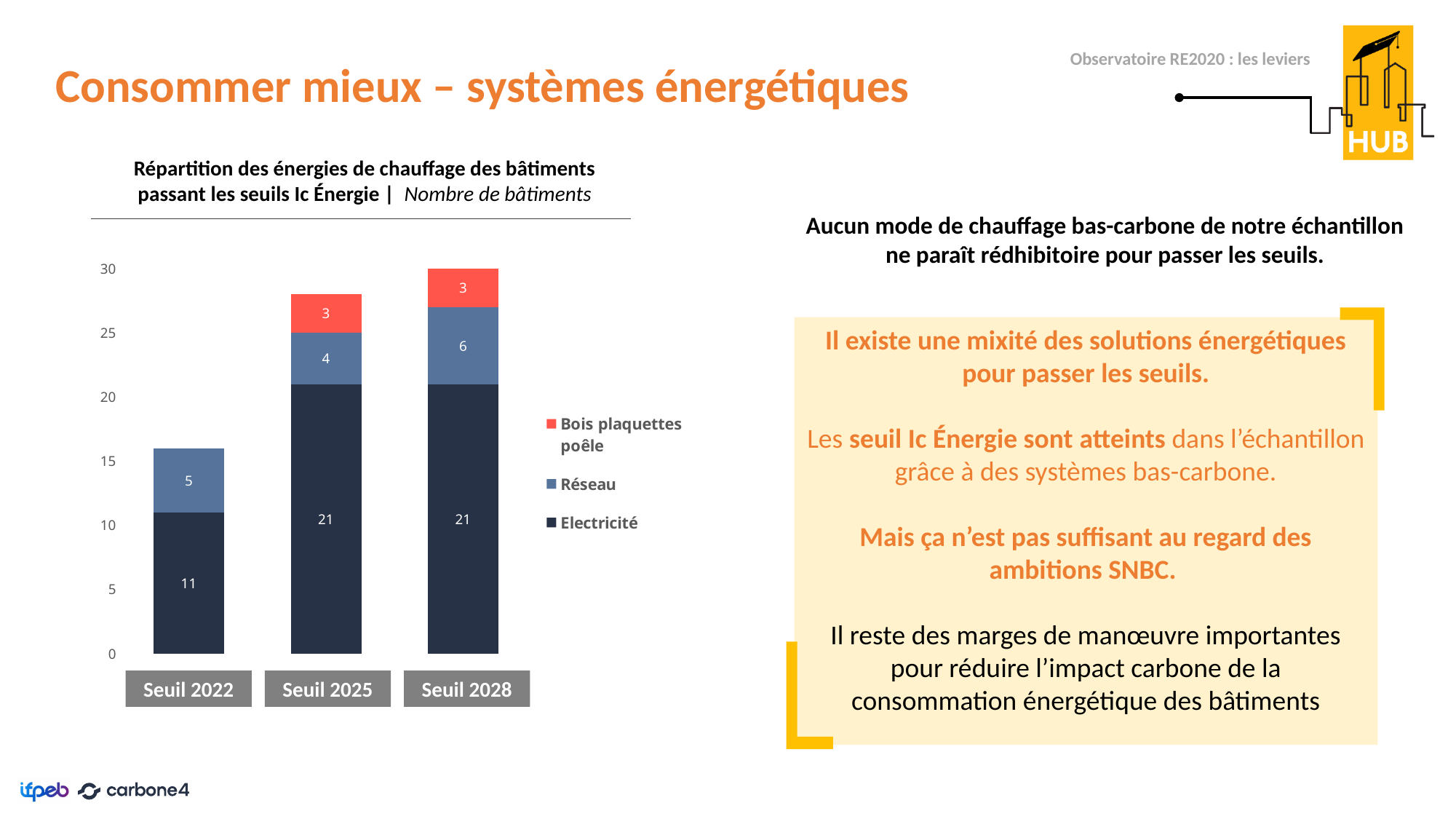
What is the Réseau value for Seuil 2028? 6 How many series does the legend list? 3 What kind of chart is shown on the slide? Stacked bar chart What is the difference between the Réseau values for Seuil 2028 and Seuil 2025? 2 Which category has the lowest total stacked bar? Seuil 2022 Which category has the highest total stacked bar? Seuil 2028 How many categories are shown on the x axis? 3 What is the Electricité value for Seuil 2022? 11 What is the Bois plaquettes poêle value for Seuil 2025? 3 What is the total of the stacked bar for Seuil 2022? 16 What is the total of the stacked bar for Seuil 2025? 28 Is the Electricité value larger for Seuil 2025 or Seuil 2022? Seuil 2025